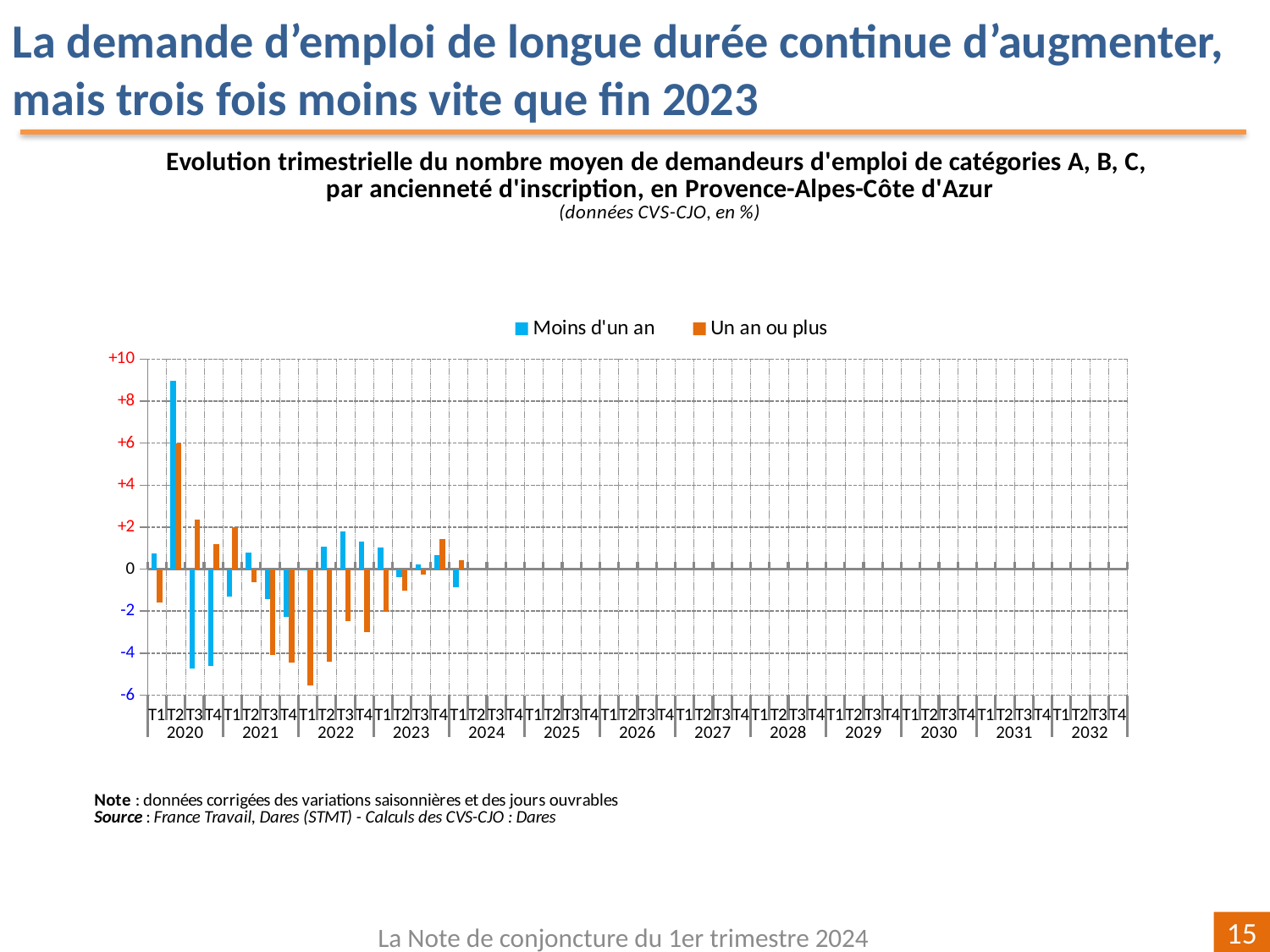
In which quarter does the 'Moins d'un an' series reach its highest value? T2 2020 In T2 2020, which series has the larger value, 'Moins d'un an' or 'Un an ou plus'? Moins d'un an What kind of chart is shown on the slide? Bar chart Is the value for 'Un an ou plus' in T1 2022 greater or less than -4? less What are the two series named in the legend? Moins d'un an; Un an ou plus Which colour represents the series 'Un an ou plus'? Orange How many series does the legend list? 2 Is the value for 'Moins d'un an' in T2 2020 greater or less than +8? greater Is the value for 'Moins d'un an' in T3 2020 greater or less than -4? less In T1 2024, which series has the larger value, 'Moins d'un an' or 'Un an ou plus'? Un an ou plus In which quarter does the 'Un an ou plus' series reach its lowest value? T1 2022 How many years are labelled along the x axis? 13